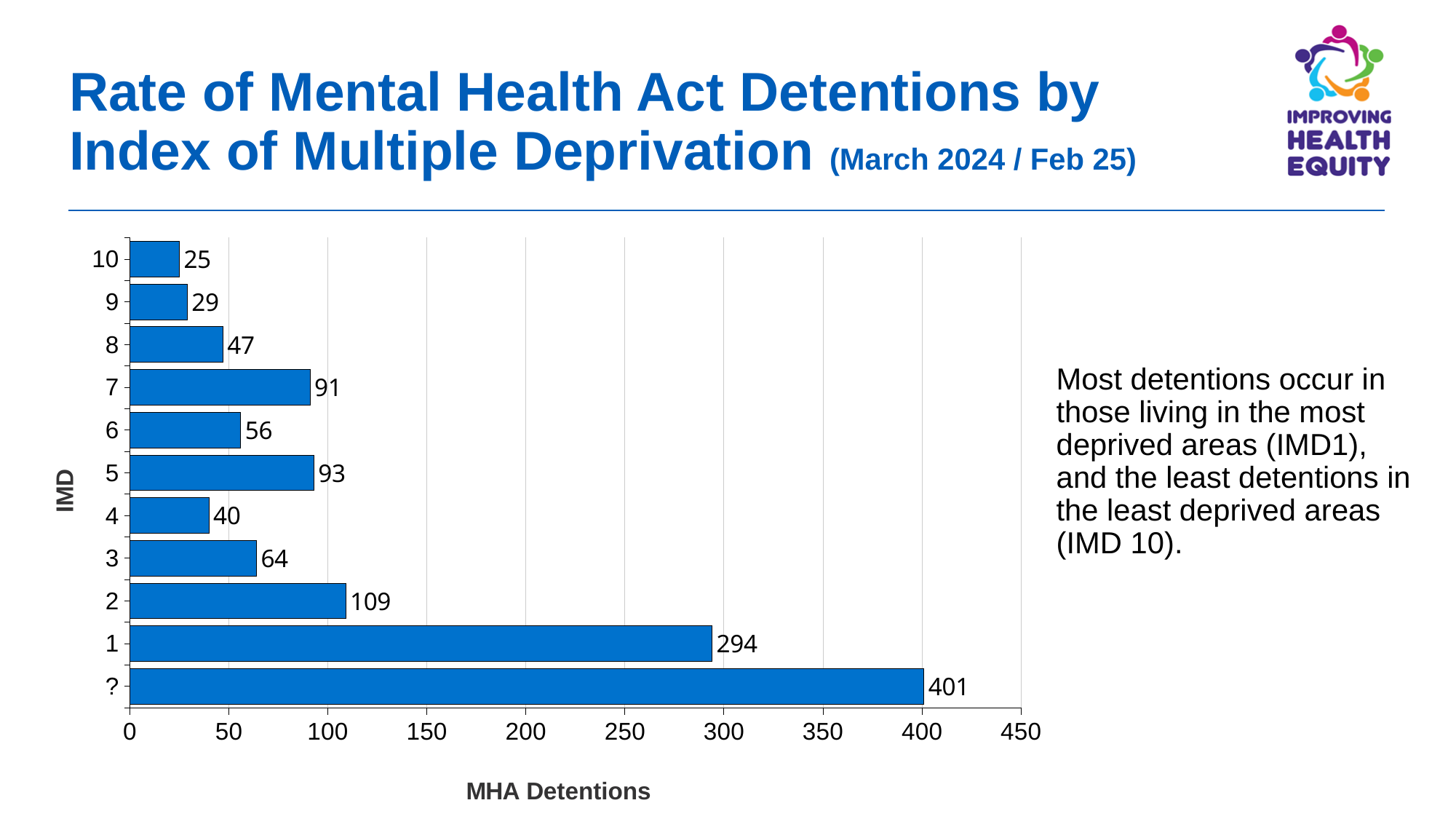
Which IMD category has the lowest number of MHA detentions? 10 How many categories are shown on the IMD axis? 11 What kind of chart is shown on the slide? Bar chart What is the number of MHA detentions for IMD 10? 25 What is the number of MHA detentions for IMD 1? 294 Which IMD category has the highest number of MHA detentions? ? Is the value for IMD 2 greater or less than 100? greater Which has more MHA detentions, IMD 5 or IMD 6? IMD 5 What is the number of MHA detentions for IMD 7? 91 What is the difference in MHA detentions between IMD 1 and IMD 2? 185 What is the label of the horizontal axis of the chart? MHA Detentions What is the number of MHA detentions for the category labelled '?'? 401